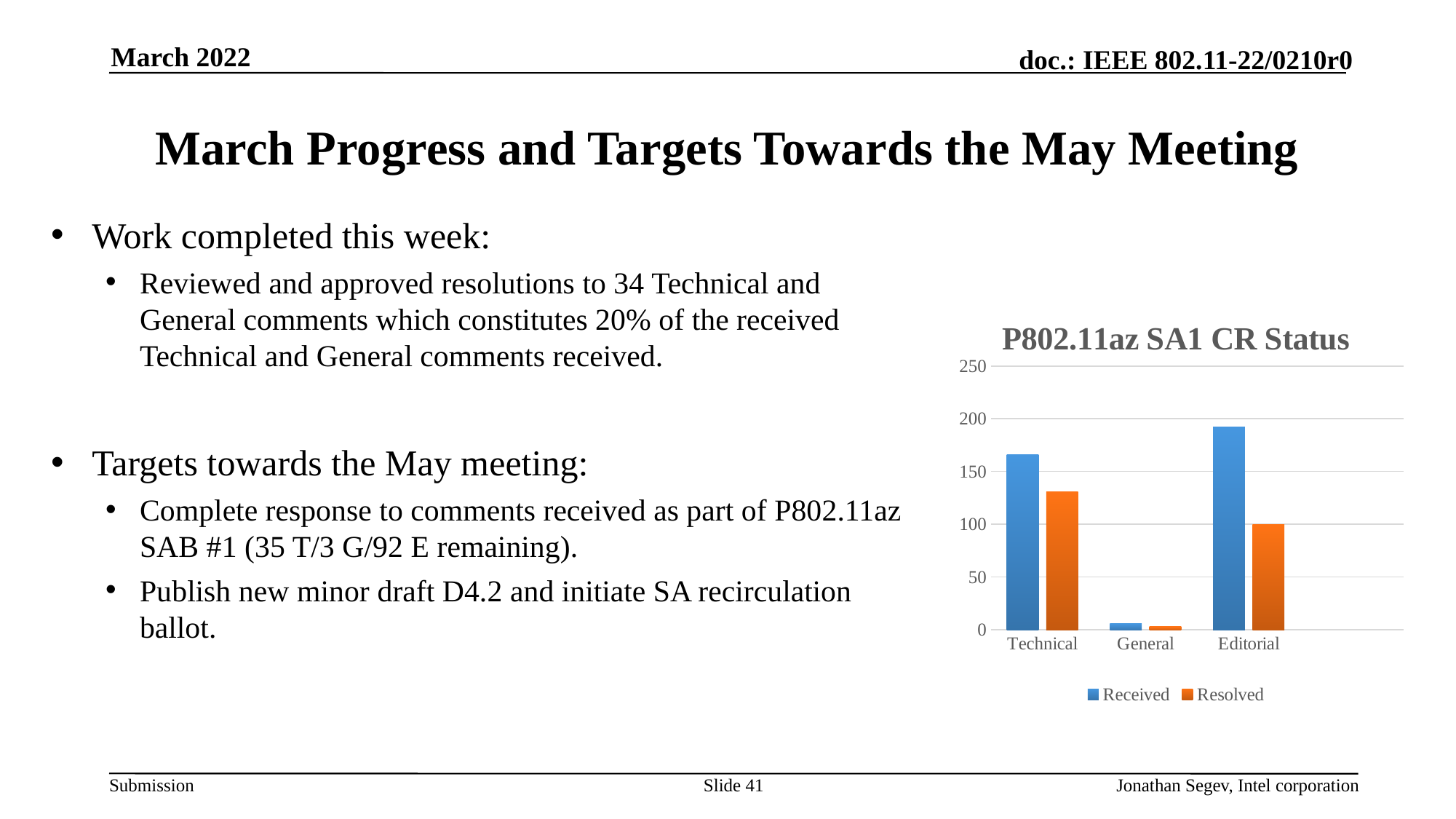
How many categories are shown on the x axis of the chart? 3 How many series does the chart legend list? 2 Which category has the highest Received value? Editorial Which is larger: the Resolved value for Technical or the Resolved value for Editorial? Technical Which category has the lowest Received value? General Which series is shown in orange in the chart? Resolved Is the Received value for Technical greater or less than 150? greater What kind of chart is shown on the slide? bar chart Is the Resolved value for Editorial greater or less than 150? less Which category has the highest Resolved value? Technical What is the title of the chart? P802.11az SA1 CR Status Is the Received value for Editorial greater or less than 200? less